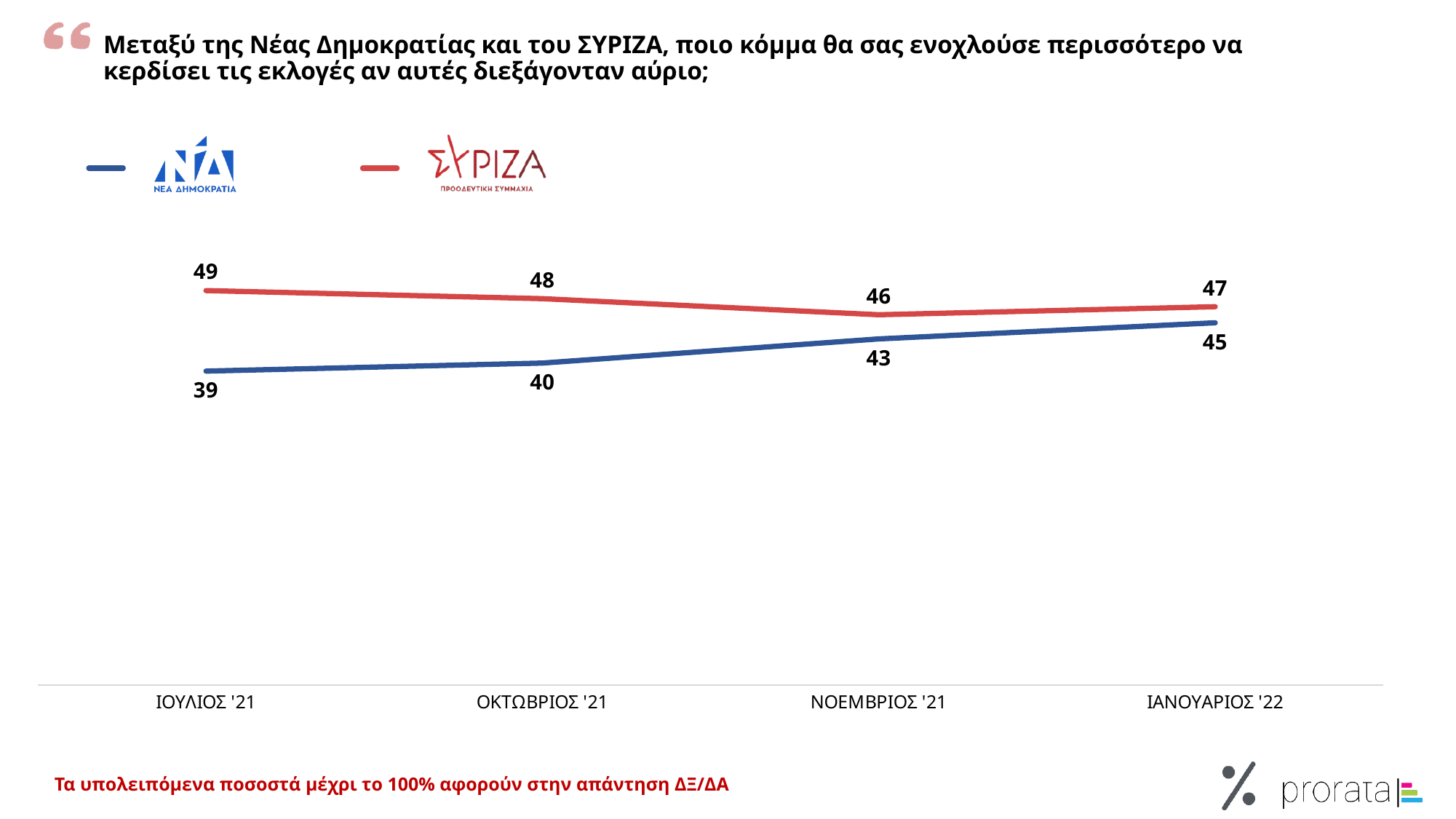
What is the value for ΣΥΡΙΖΑ in ΙΟΥΛΙΟΣ '21? 49 What kind of chart is shown on the slide? Line chart In which period is the value for ΝΕΑ ΔΗΜΟΚΡΑΤΙΑ lowest? ΙΟΥΛΙΟΣ '21 What is the difference between ΣΥΡΙΖΑ and ΝΕΑ ΔΗΜΟΚΡΑΤΙΑ in ΙΑΝΟΥΑΡΙΟΣ '22? 2 What is the difference between ΣΥΡΙΖΑ and ΝΕΑ ΔΗΜΟΚΡΑΤΙΑ in ΙΟΥΛΙΟΣ '21? 10 Which series has the higher value in ΝΟΕΜΒΡΙΟΣ '21, ΝΕΑ ΔΗΜΟΚΡΑΤΙΑ or ΣΥΡΙΖΑ? ΣΥΡΙΖΑ How many series does the legend list? 2 In which period is the value for ΣΥΡΙΖΑ highest? ΙΟΥΛΙΟΣ '21 What is the value for ΝΕΑ ΔΗΜΟΚΡΑΤΙΑ in ΙΑΝΟΥΑΡΙΟΣ '22? 45 What is the value for ΣΥΡΙΖΑ in ΟΚΤΩΒΡΙΟΣ '21? 48 How many time periods are shown on the x axis? 4 What is the value for ΝΕΑ ΔΗΜΟΚΡΑΤΙΑ in ΝΟΕΜΒΡΙΟΣ '21? 43